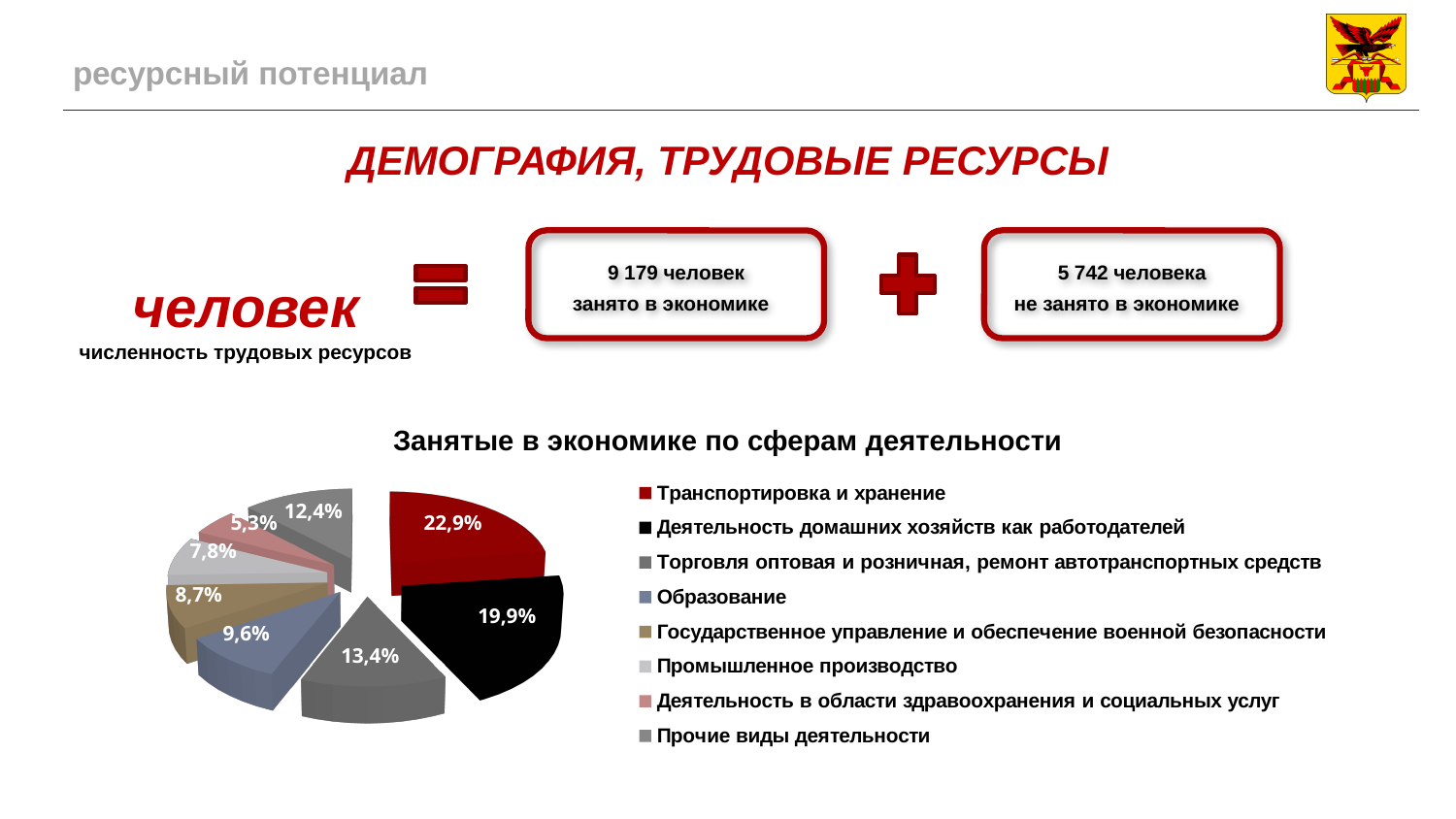
What kind of chart is shown on the slide? pie chart What share is shown for Прочие виды деятельности? 12,4% Which has a larger share: Государственное управление и обеспечение военной безопасности or Промышленное производство? Государственное управление и обеспечение военной безопасности How many slices does the pie chart have? 8 Which sphere of activity has the largest share of the pie? Транспортировка и хранение What share is shown for Деятельность домашних хозяйств как работодателей? 19,9% What is the difference between the shares for Транспортировка и хранение and Деятельность домашних хозяйств как работодателей? 3,0% What share is shown for Торговля оптовая и розничная, ремонт автотранспортных средств? 13,4% What share of those employed in the economy works in Транспортировка и хранение? 22,9% Which sphere of activity has the smallest share of the pie? Деятельность в области здравоохранения и социальных услуг What is the title of the pie chart? Занятые в экономике по сферам деятельности What share is shown for Образование? 9,6%